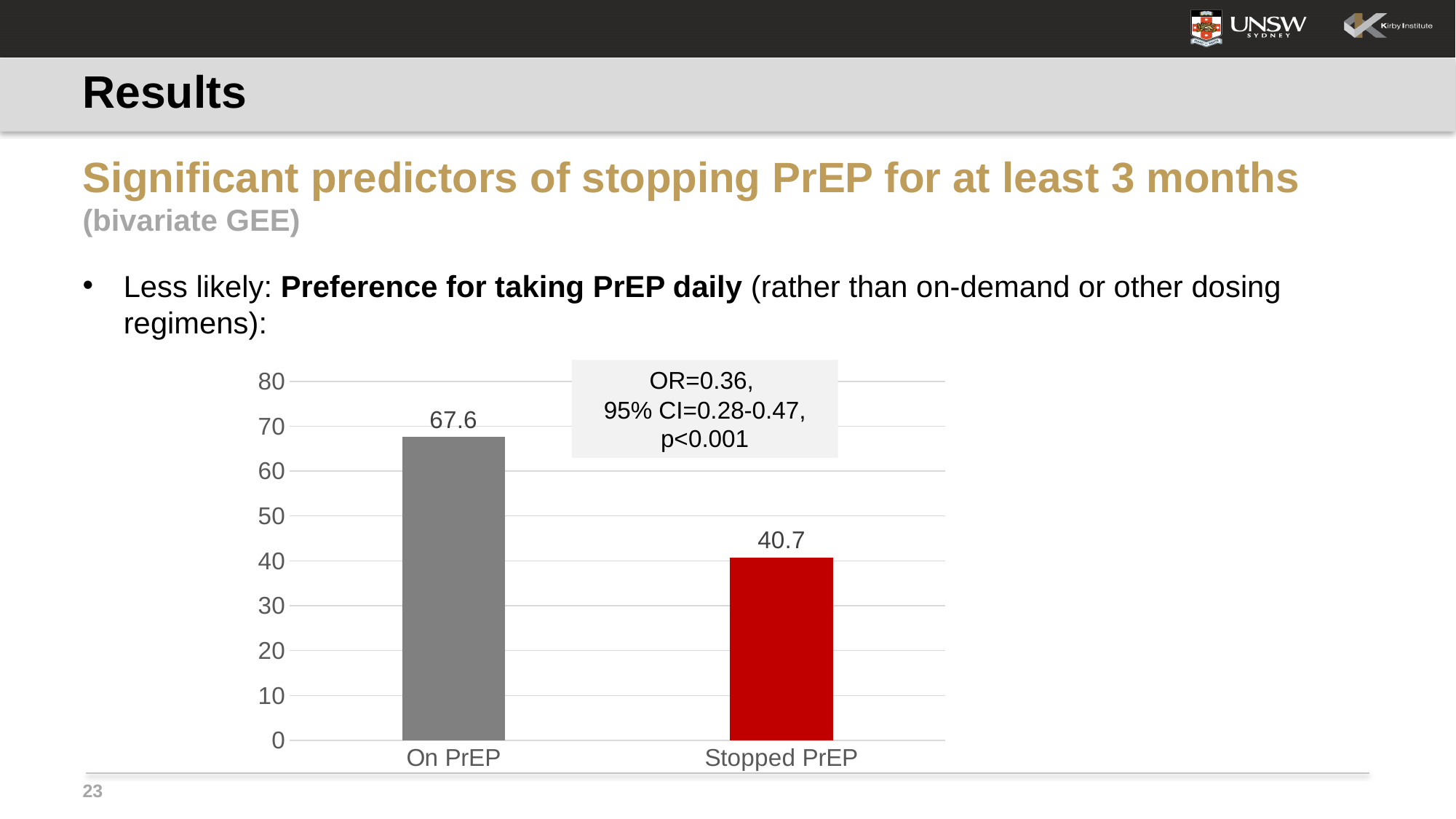
Which category has the lowest value? Stopped PrEP Is the value for Stopped PrEP greater or less than 50? less Which is larger, the value for On PrEP or the value for Stopped PrEP? On PrEP What odds ratio is shown in the text box on the chart? OR=0.36 What is the value for Stopped PrEP? 40.7 What is the value for On PrEP? 67.6 Which category has the highest value? On PrEP What kind of chart is shown on the slide? bar chart How many categories are shown on the chart? 2 What is the difference between the values for On PrEP and Stopped PrEP? 26.9 What colour is the bar for Stopped PrEP? red Is the value for On PrEP greater or less than 60? greater